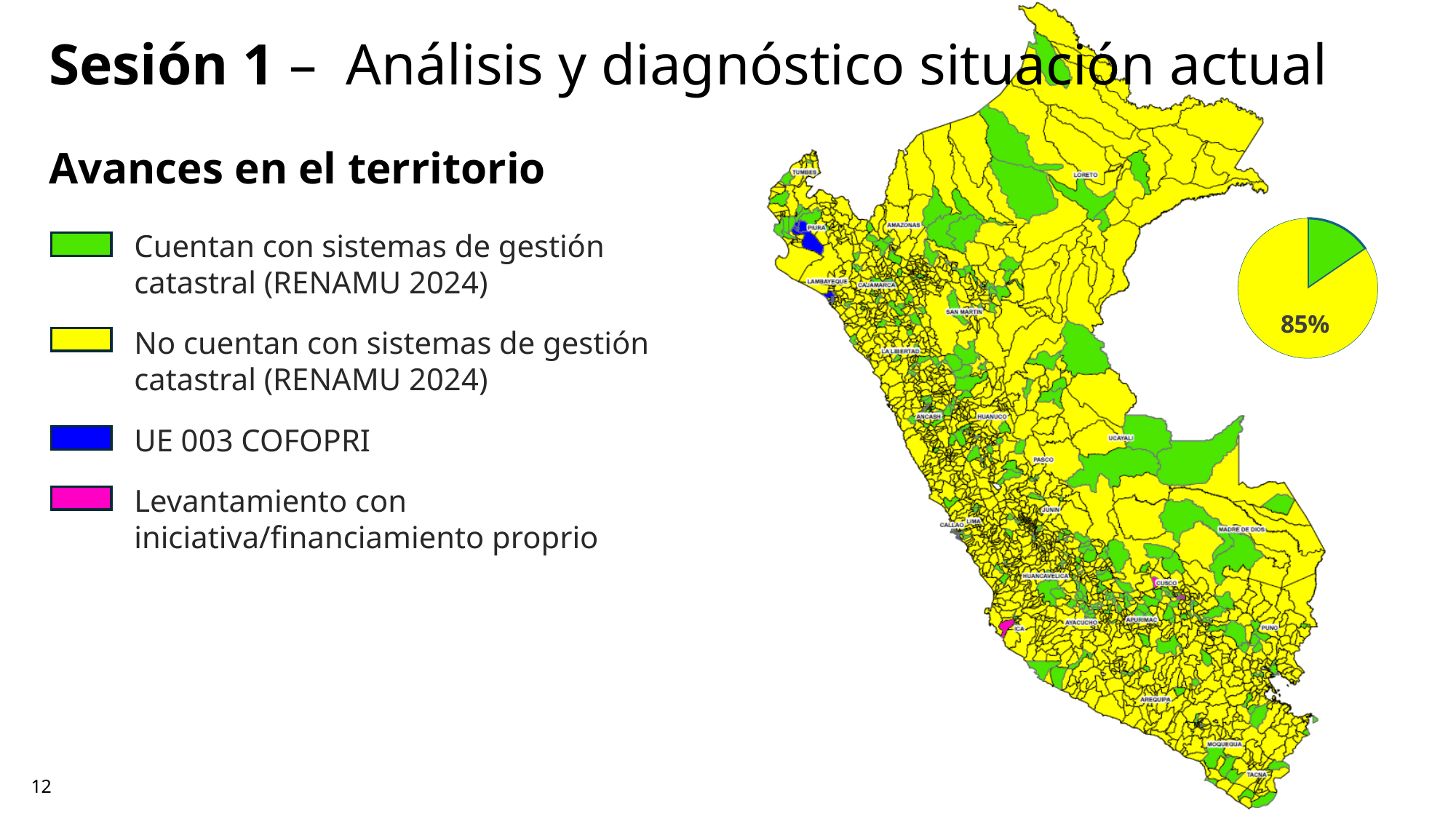
According to the legend on the slide, what does the green colour represent? Cuentan con sistemas de gestión catastral (RENAMU 2024) According to the legend on the slide, what does the yellow colour represent? No cuentan con sistemas de gestión catastral (RENAMU 2024) What kind of chart is shown at the right of the slide, next to the map? pie chart How many slices does the pie chart have? 2 What share of the pie chart does the yellow slice represent? 85% In the pie chart, which slice is larger, the yellow one or the green one? yellow In the pie chart, what percentage is printed on the yellow slice? 85% In the pie chart, is the green slice greater or less than 50% of the pie? less